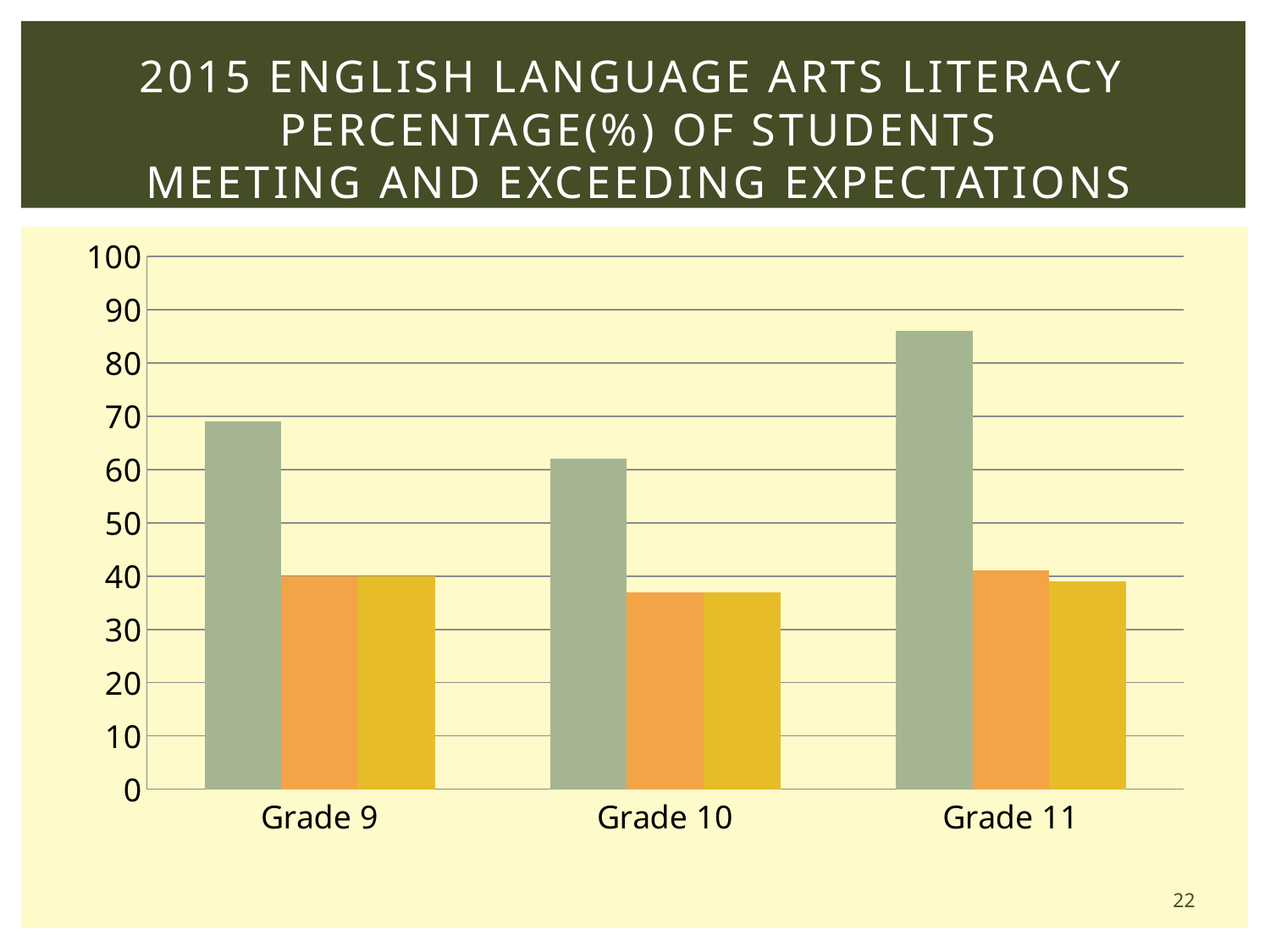
What kind of chart is shown on the slide? bar chart Is the orange bar for Grade 10 greater or less than 40? less Is the yellow bar for Grade 11 greater or less than 50? less Is the green-gray bar for Grade 9 greater or less than 60? greater What year is referenced in the chart's title? 2015 Which grade has the shortest green-gray bar? Grade 10 How many grade categories are shown on the x axis? 3 Which grade has the tallest green-gray bar? Grade 11 How many bars are plotted for each grade? 3 Which is larger, the green-gray bar for Grade 9 or the green-gray bar for Grade 10? Grade 9